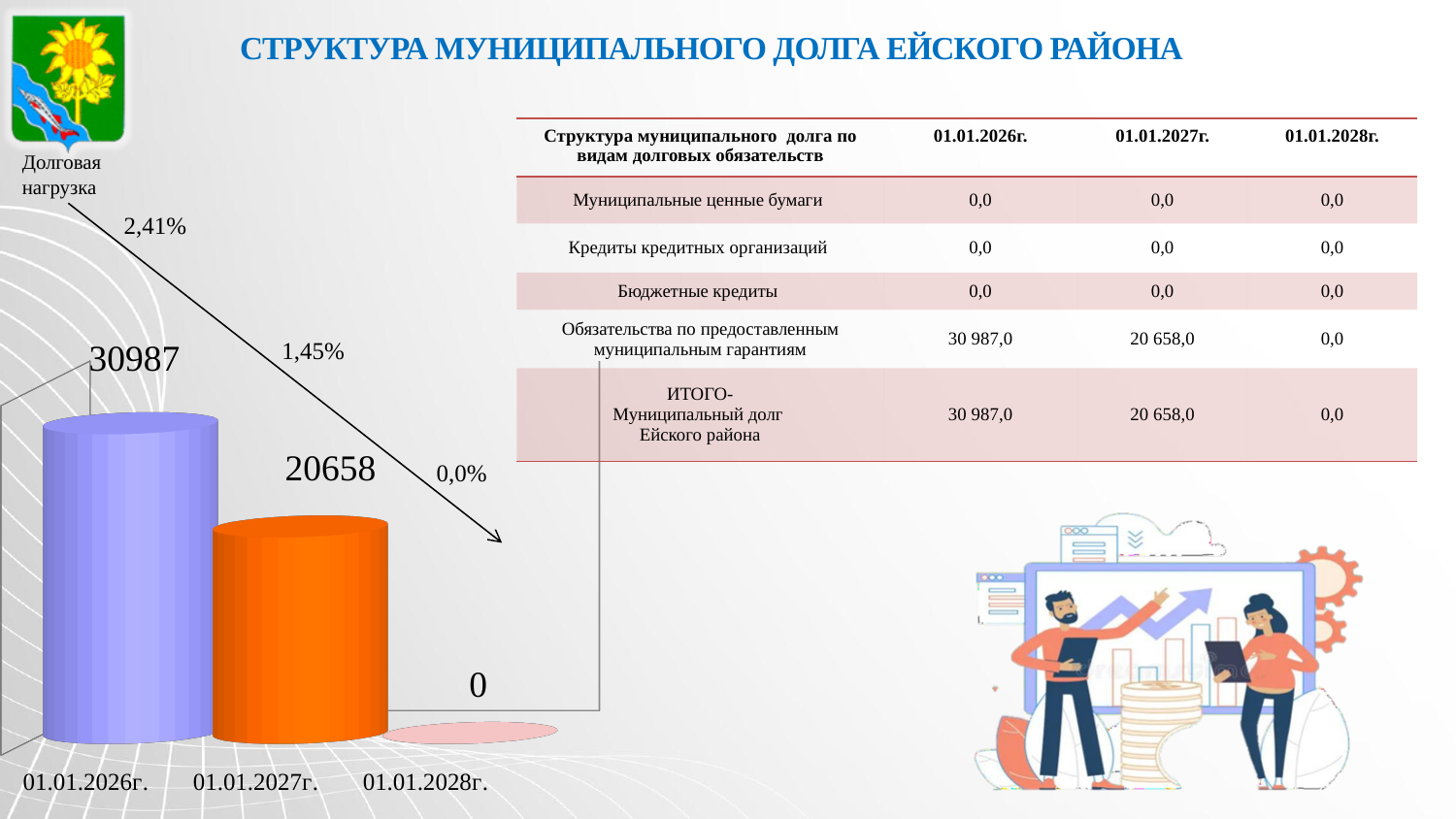
What colour is the bar for 01.01.2027г.? Orange What is the value shown for 01.01.2026г. on the chart? 30987 What debt load (Долговая нагрузка) percentage is shown for 01.01.2026г.? 2,41% What kind of chart is shown on the slide? Bar chart Which is larger, the value for 01.01.2026г. or the value for 01.01.2027г.? 01.01.2026г. Do the values rise or fall from 01.01.2026г. to 01.01.2028г.? Fall What is the value shown for 01.01.2028г. on the chart? 0 What is the difference between the values for 01.01.2026г. and 01.01.2027г.? 10329 Which date has the highest value on the chart? 01.01.2026г. Which date has the lowest value on the chart? 01.01.2028г. How many dates are shown on the chart's x axis? 3 What is the value shown for 01.01.2027г. on the chart? 20658